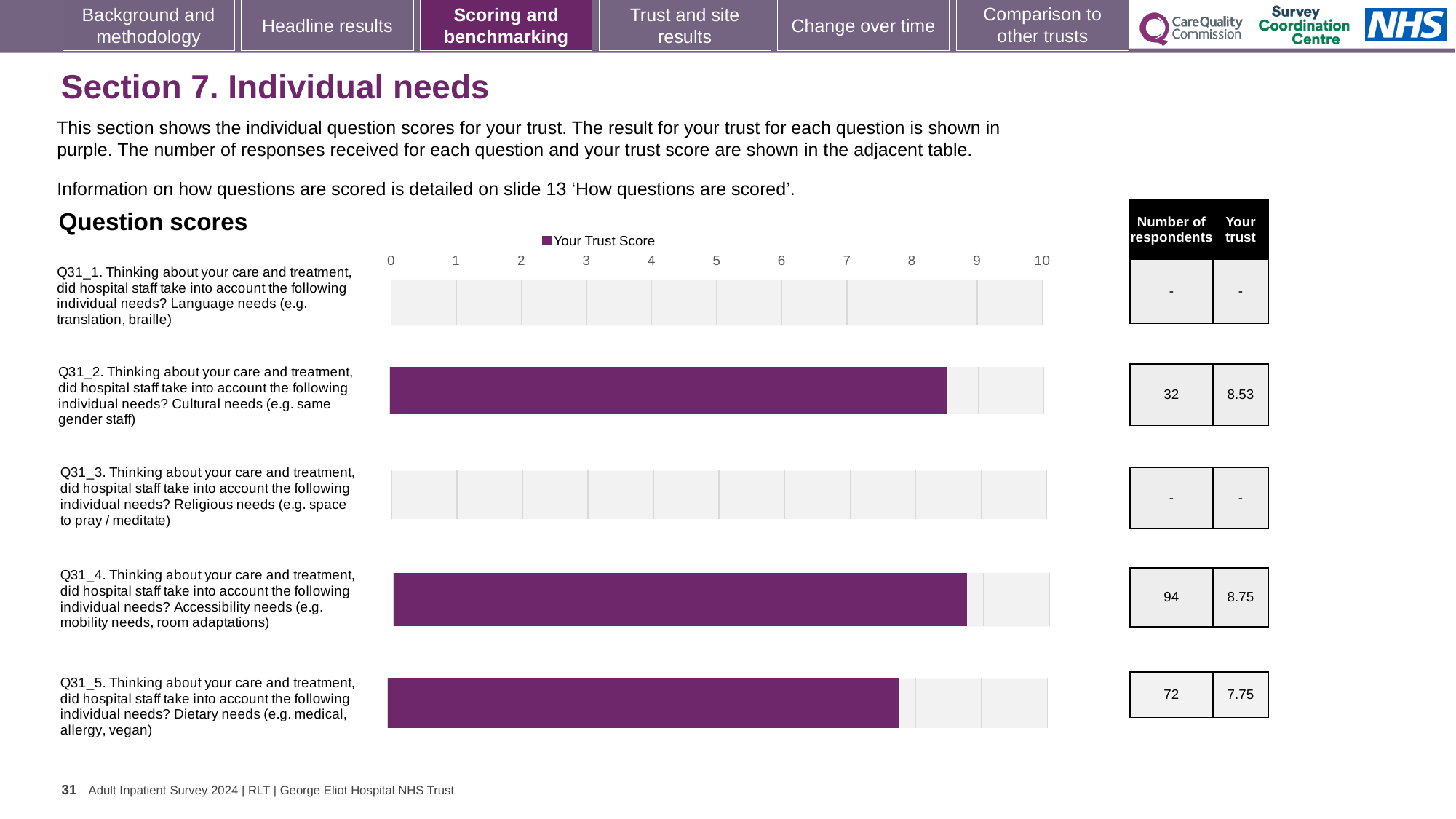
What is the trust score for Q31_5 (Dietary needs)? 7.75 What is the trust score for Q31_4 (Accessibility needs)? 8.75 What is the difference between the trust scores for Q31_4 and Q31_5? 1 What is the trust score for Q31_2 (Cultural needs)? 8.53 What kind of chart is shown on the slide? Bar chart How many series does the legend list? 1 Which has a higher trust score, Q31_2 or Q31_5? Q31_2 Is the trust score for Q31_5 greater or less than 8? less How many questions are listed on the chart? 5 Which question has the highest trust score on the chart? Q31_4 (Accessibility needs) Among the questions with a plotted bar, which has the lowest trust score? Q31_5 (Dietary needs) What is the name of the series shown in the legend? Your Trust Score